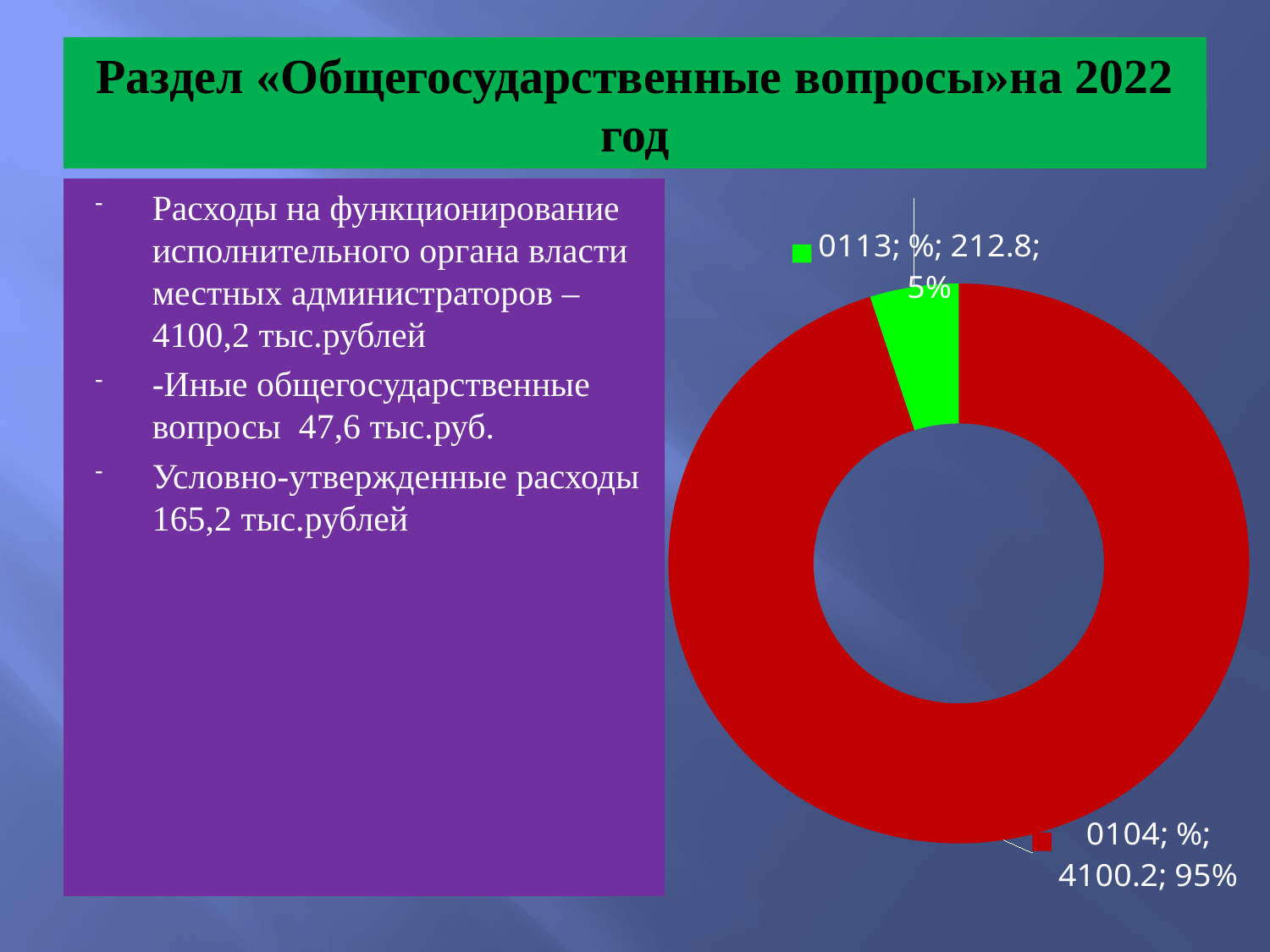
Which category has the smallest slice in the doughnut chart? 0113 What share of the doughnut chart does category 0104 represent? 95% Which category has the largest slice in the doughnut chart? 0104 What value is shown for category 0104 in the doughnut chart? 4100.2 What share of the doughnut chart does category 0113 represent? 5% What colour is the slice for category 0104 in the doughnut chart? red What kind of chart is shown on the slide? doughnut chart How many slices does the doughnut chart have? 2 What colour is the slice for category 0113 in the doughnut chart? green What value is shown for category 0113 in the doughnut chart? 212.8 What is the difference between the values for 0104 and 0113 in the doughnut chart? 3887.4 Which is larger in the doughnut chart, the value for 0104 or the value for 0113? 0104